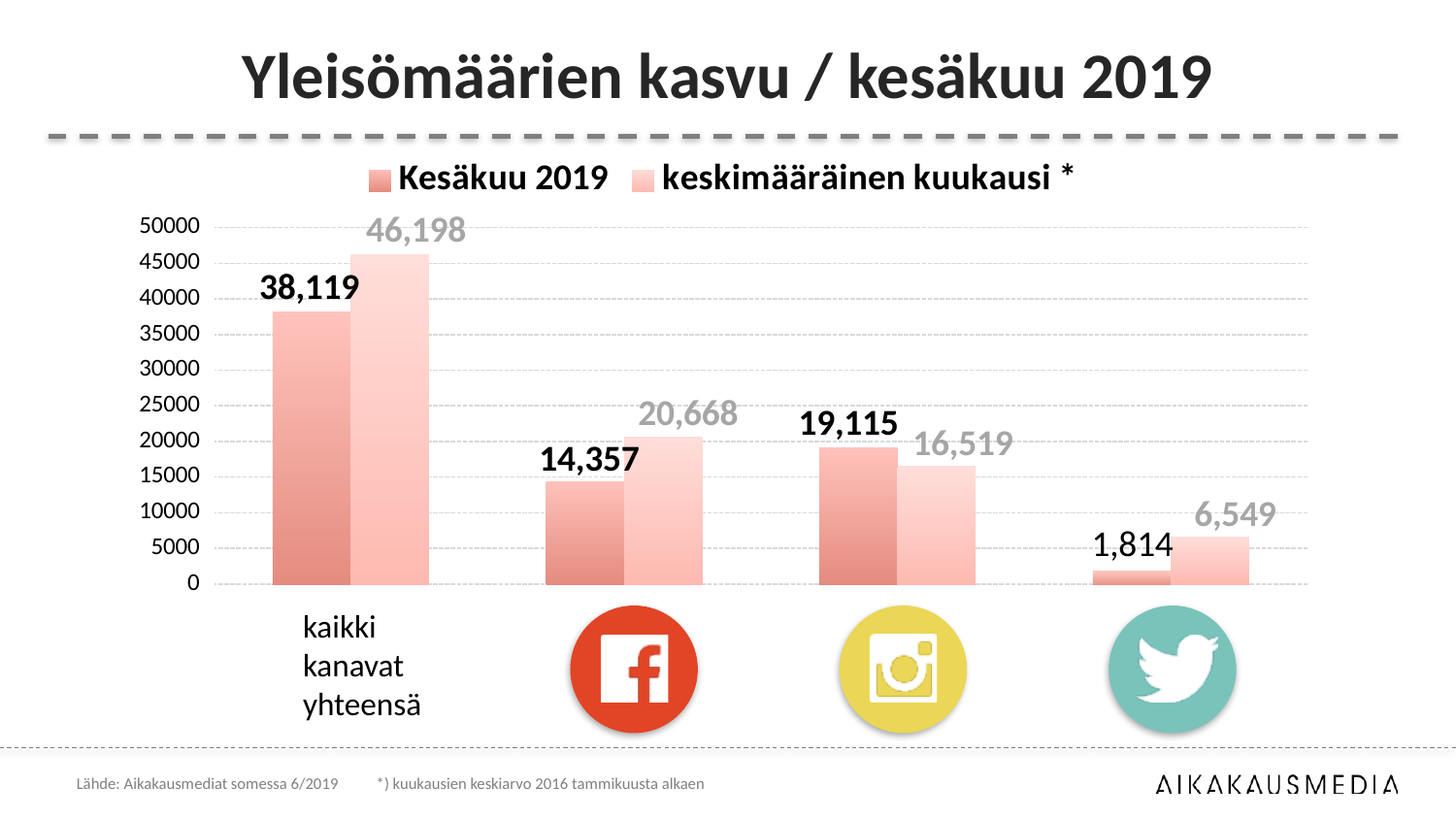
How many series does the legend list? 2 What is the Kesäkuu 2019 value for the Facebook category? 14,357 What is the keskimääräinen kuukausi value for the Twitter category? 6,549 What kind of chart is shown on the slide? Bar chart What is the title of the slide? Yleisömäärien kasvu / kesäkuu 2019 What is the keskimääräinen kuukausi value for kaikki kanavat yhteensä? 46,198 Which category has the highest keskimääräinen kuukausi value? kaikki kanavat yhteensä Which category has the lowest Kesäkuu 2019 value? Twitter What is the Kesäkuu 2019 value for kaikki kanavat yhteensä? 38,119 For the Instagram category, which is larger: the Kesäkuu 2019 value or the keskimääräinen kuukausi value? Kesäkuu 2019 What is the difference between the keskimääräinen kuukausi and Kesäkuu 2019 values for kaikki kanavat yhteensä? 8,079 How many categories are shown on the x axis? 4